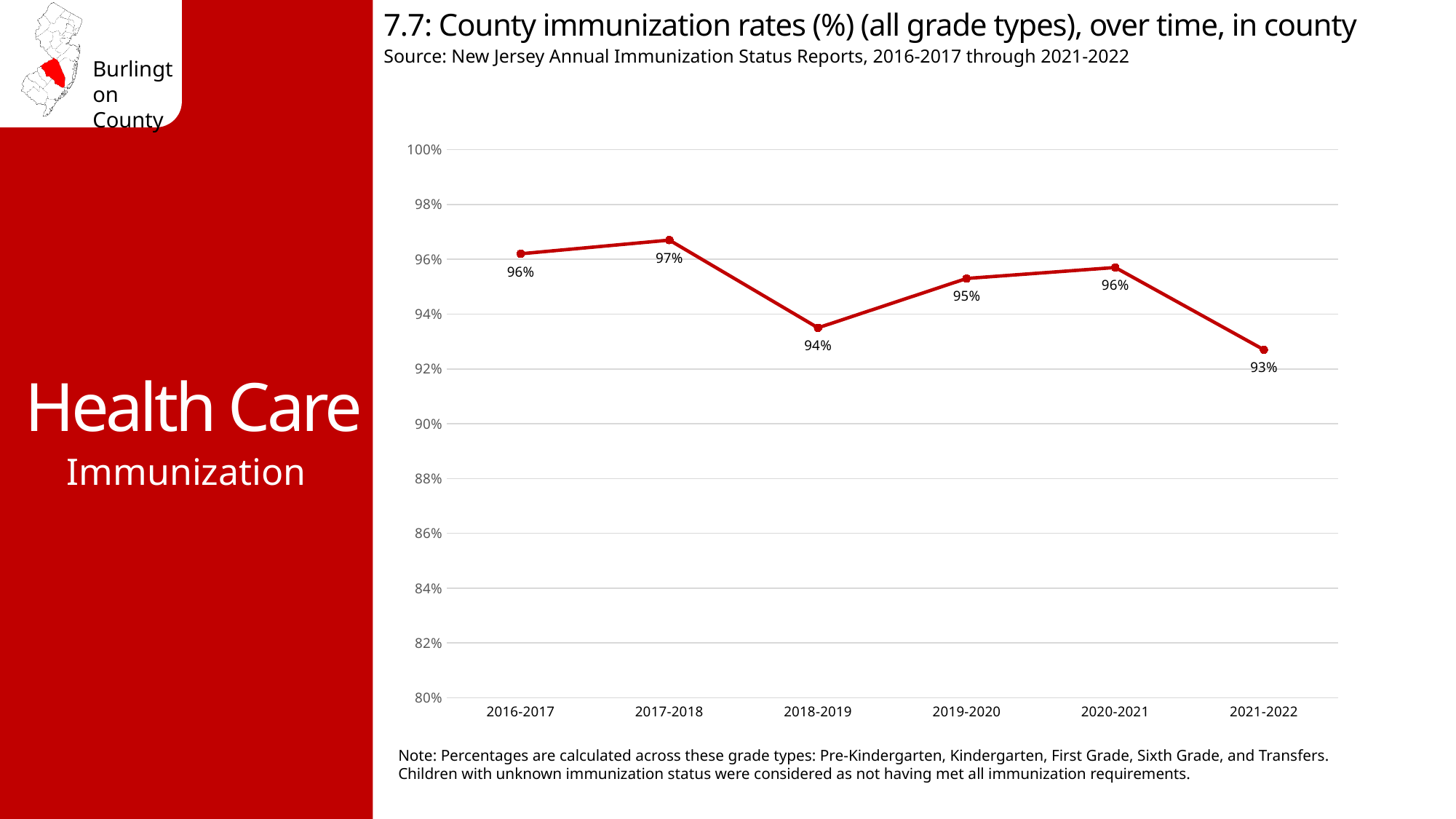
Does the immunization rate rise or fall from 2020-2021 to 2021-2022? Fall What kind of chart is shown on the slide? Line chart Is the value for 2021-2022 greater or less than 92%? greater What is the county immunization rate for 2018-2019? 94% Which school year has the lowest immunization rate? 2021-2022 Which is larger, the immunization rate for 2019-2020 or for 2018-2019? 2019-2020 What is the county immunization rate for 2017-2018? 97% What is the difference in percentage points between the 2017-2018 rate and the 2021-2022 rate? 4 percentage points What is the county immunization rate for 2021-2022? 93% How many school years are plotted on the chart? 6 What is the county immunization rate for 2019-2020? 95% Which school year has the highest immunization rate? 2017-2018